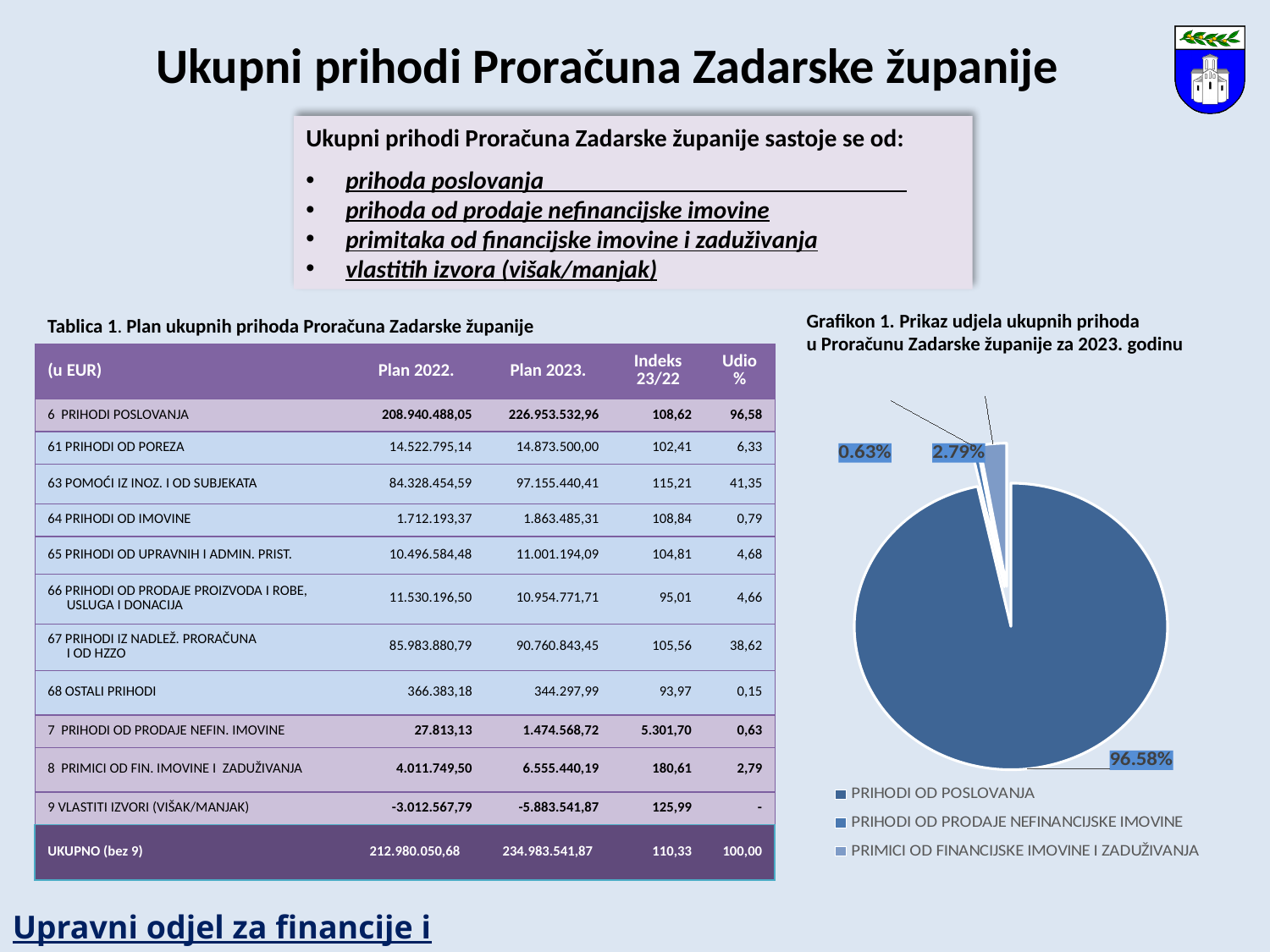
In the pie chart, what share is shown for PRIMICI OD FINANCIJSKE IMOVINE I ZADUŽIVANJA? 2.79% What kind of chart is Grafikon 1 on the slide? pie chart Which category has the smallest slice in the pie chart? PRIHODI OD PRODAJE NEFINANCIJSKE IMOVINE In the pie chart, what share is shown for PRIHODI OD POSLOVANJA? 96.58% In the pie chart, which is larger: the slice for PRIMICI OD FINANCIJSKE IMOVINE I ZADUŽIVANJA or the slice for PRIHODI OD PRODAJE NEFINANCIJSKE IMOVINE? PRIMICI OD FINANCIJSKE IMOVINE I ZADUŽIVANJA Which legend entry is listed first under the pie chart? PRIHODI OD POSLOVANJA In the pie chart, what is the difference in percentage points between the 2.79% slice and the 0.63% slice? 2.16 How many entries does the legend of the pie chart list? 3 In the pie chart, what share is shown for PRIHODI OD PRODAJE NEFINANCIJSKE IMOVINE? 0.63% How many slices does the pie chart have? 3 What is the title of the pie chart on the slide? Grafikon 1. Prikaz udjela ukupnih prihoda u Proračunu Zadarske županije za 2023. godinu Which category has the largest slice in the pie chart? PRIHODI OD POSLOVANJA